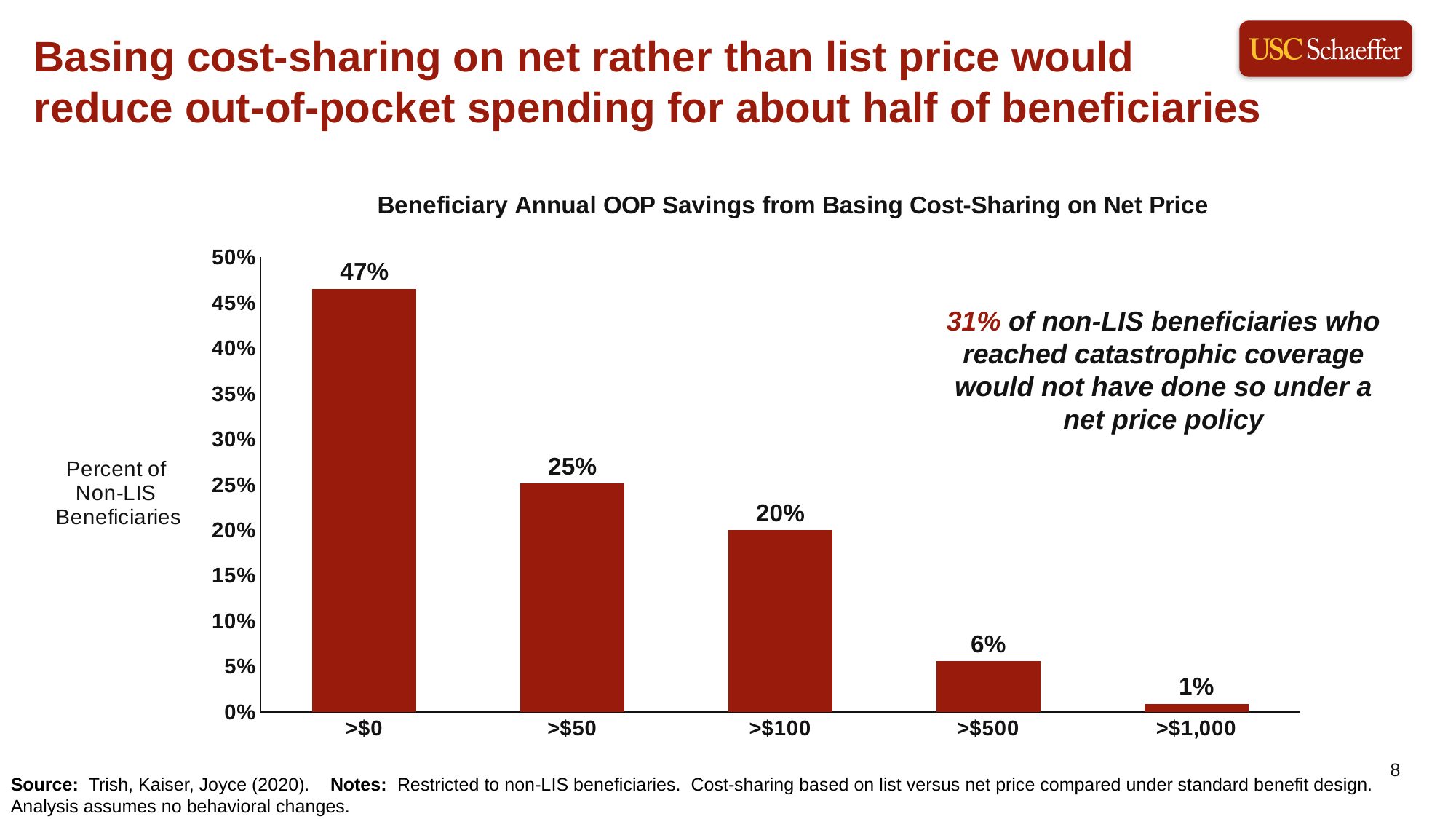
Which savings category has the lowest percent of non-LIS beneficiaries? >$1,000 What percent of non-LIS beneficiaries have annual OOP savings of >$0? 47% What kind of chart is shown on the slide? Bar chart Which savings category has the highest percent of non-LIS beneficiaries? >$0 What percent of non-LIS beneficiaries have savings of >$1,000? 1% Is the value for >$500 greater or less than 10%? less What is the difference in percentage points between the >$0 and >$50 categories? 22 How many savings categories are shown on the x axis? 5 What is the difference in percentage points between the >$100 and >$500 categories? 14 What is the value shown for the >$100 savings category? 20% Which is larger, the value for >$50 or the value for >$100? >$50 Do the values rise or fall moving from >$0 to >$1,000 along the x axis? Fall